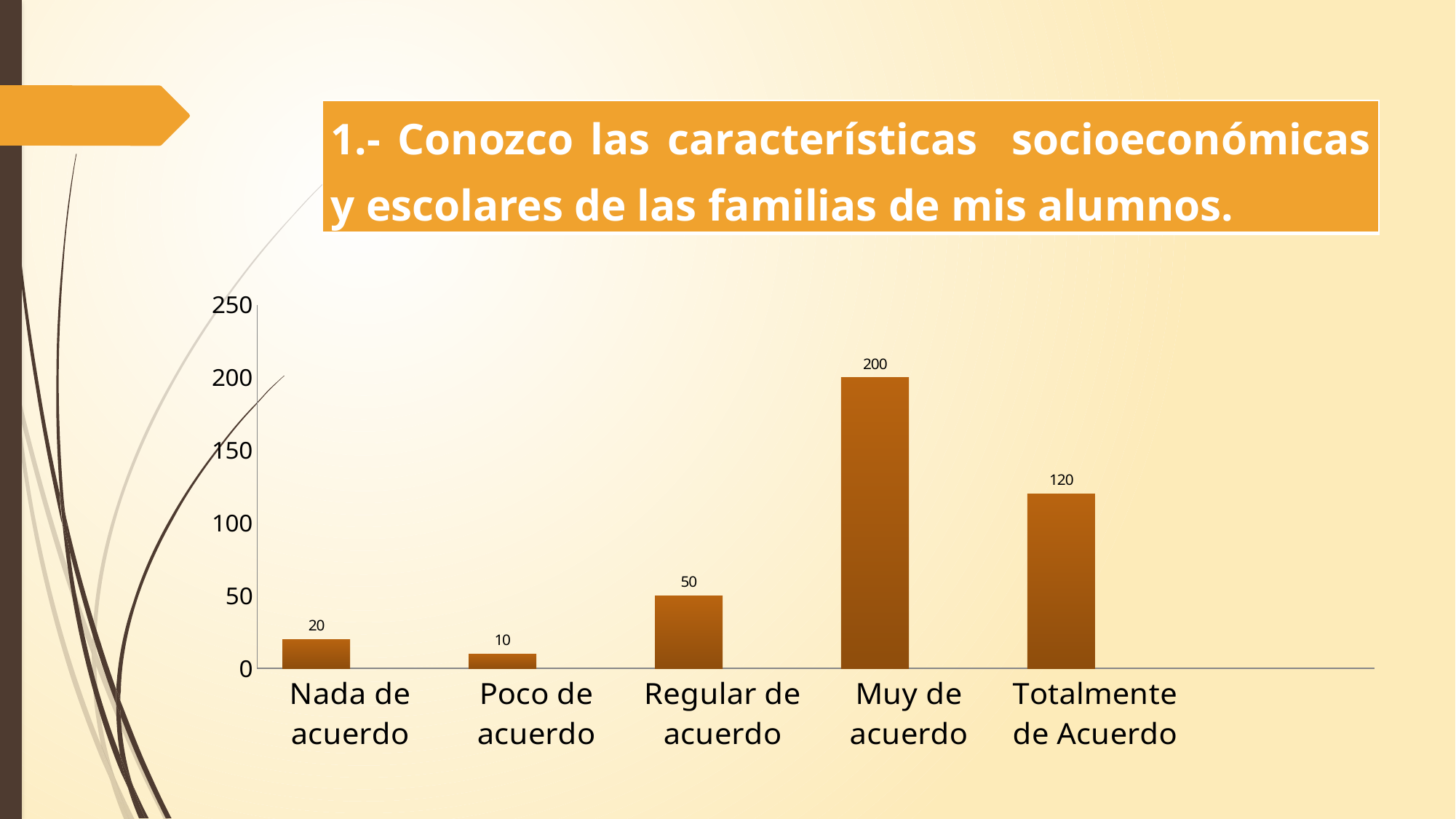
What is the value for "Totalmente de Acuerdo"? 120 What kind of chart is shown on the slide? bar chart What is the difference between the values for "Muy de acuerdo" and "Totalmente de Acuerdo"? 80 What is the value for "Nada de acuerdo"? 20 Which category has the highest value? Muy de acuerdo Which category has the lowest value? Poco de acuerdo Which is larger, the value for "Regular de acuerdo" or the value for "Nada de acuerdo"? Regular de acuerdo How many categories are shown on the x axis? 5 What is the highest value shown on the y axis? 250 Is the value for "Totalmente de Acuerdo" greater or less than 100? greater What is the total of all five bar values? 400 What is the value for "Muy de acuerdo"? 200